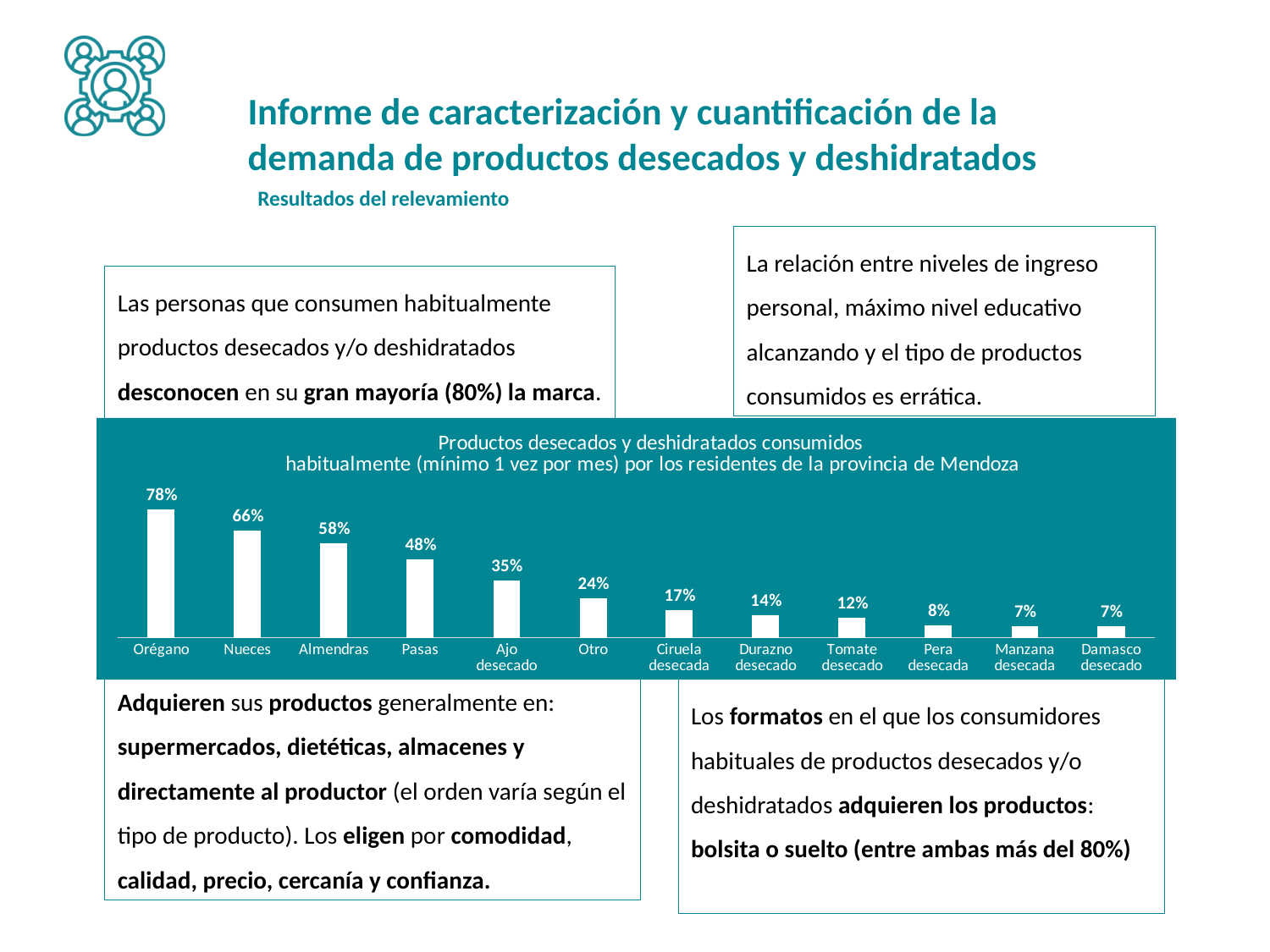
Which category has the highest value? Orégano What is the difference between the values for Nueces and Almendras? 8% What is the title of the chart? Productos desecados y deshidratados consumidos habitualmente (mínimo 1 vez por mes) por los residentes de la provincia de Mendoza How many categories are shown in the chart? 12 What is the value for Ajo desecado? 35% What kind of chart is shown on the slide? bar chart What is the difference between the values for Pasas and Ciruela desecada? 31% What is the value for Pera desecada? 8% Which is larger, the value for Otro or the value for Durazno desecado? Otro What is the value for Orégano? 78% What is the value for Tomate desecado? 12% Do the values rise or fall from left to right along the x axis? fall